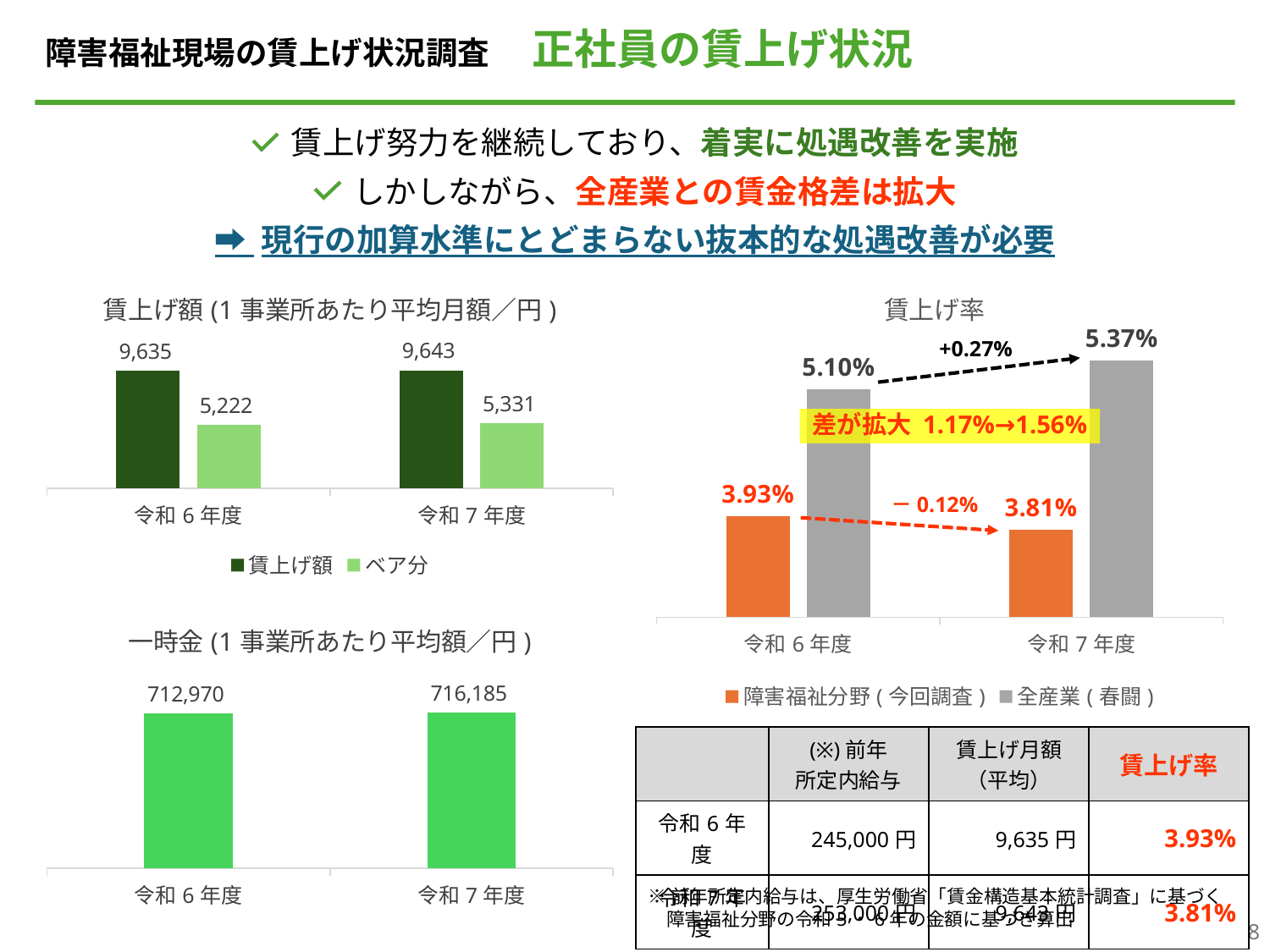
What kind of chart is the 一時金 chart? bar chart In the 賃上げ額 chart, what is the difference between 賃上げ額 and ベア分 for 令和6年度? 4,413 In the 賃上げ率 chart, what is the value for 全産業(春闘) in 令和7年度? 5.37% In the 賃上げ率 chart, what is the value for 障害福祉分野(今回調査) in 令和6年度? 3.93% In the 一時金 chart, what is the difference between 令和7年度 and 令和6年度? 3,215 In the 賃上げ率 chart, which series is shown in orange? 障害福祉分野(今回調査) In the 賃上げ率 chart, does the value for 障害福祉分野(今回調査) rise or fall from 令和6年度 to 令和7年度? fall In the 一時金 chart, which year has the higher value, 令和6年度 or 令和7年度? 令和7年度 In the 一時金 chart, what is the value for 令和7年度? 716,185 In the 賃上げ額 chart, what is the value of ベア分 for 令和7年度? 5,331 In the 賃上げ額 chart, what is the value of 賃上げ額 for 令和6年度? 9,635 In the 賃上げ額 chart, how many series does the legend list? 2